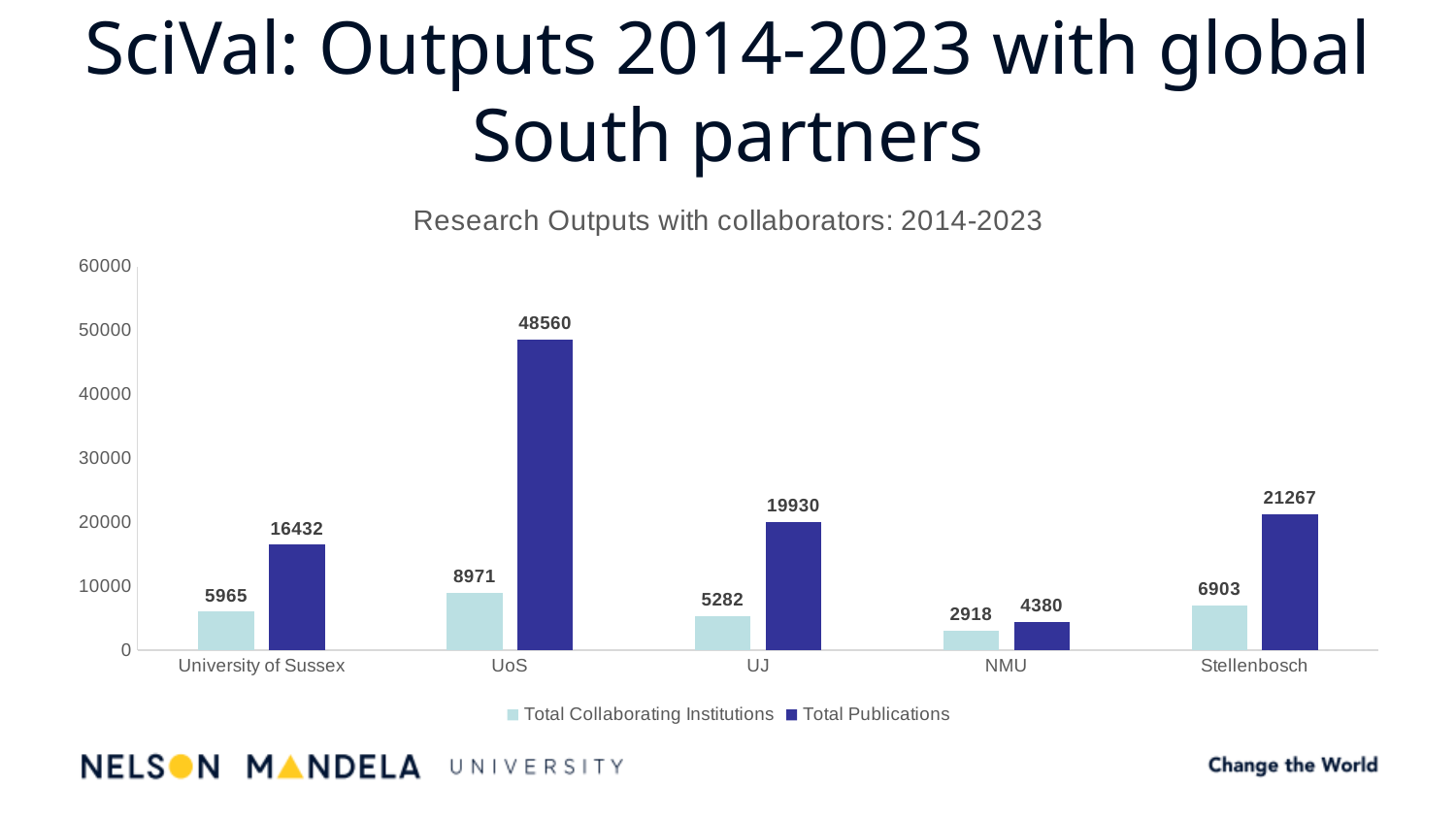
Which institution has the lowest Total Collaborating Institutions? NMU What is the Total Collaborating Institutions value for NMU? 2918 Which is larger: Total Collaborating Institutions for Stellenbosch or for University of Sussex? Stellenbosch What is the title of the chart? Research Outputs with collaborators: 2014-2023 What kind of chart is shown? bar chart Is the Total Publications value for UoS greater or less than 40000? greater What is the Total Publications value for Stellenbosch? 21267 What is the Total Publications value for UoS? 48560 Which institution has the highest Total Publications? UoS How many institutions are shown on the x axis? 5 What is the difference between Total Publications for UJ and University of Sussex? 3498 How many series does the legend list? 2